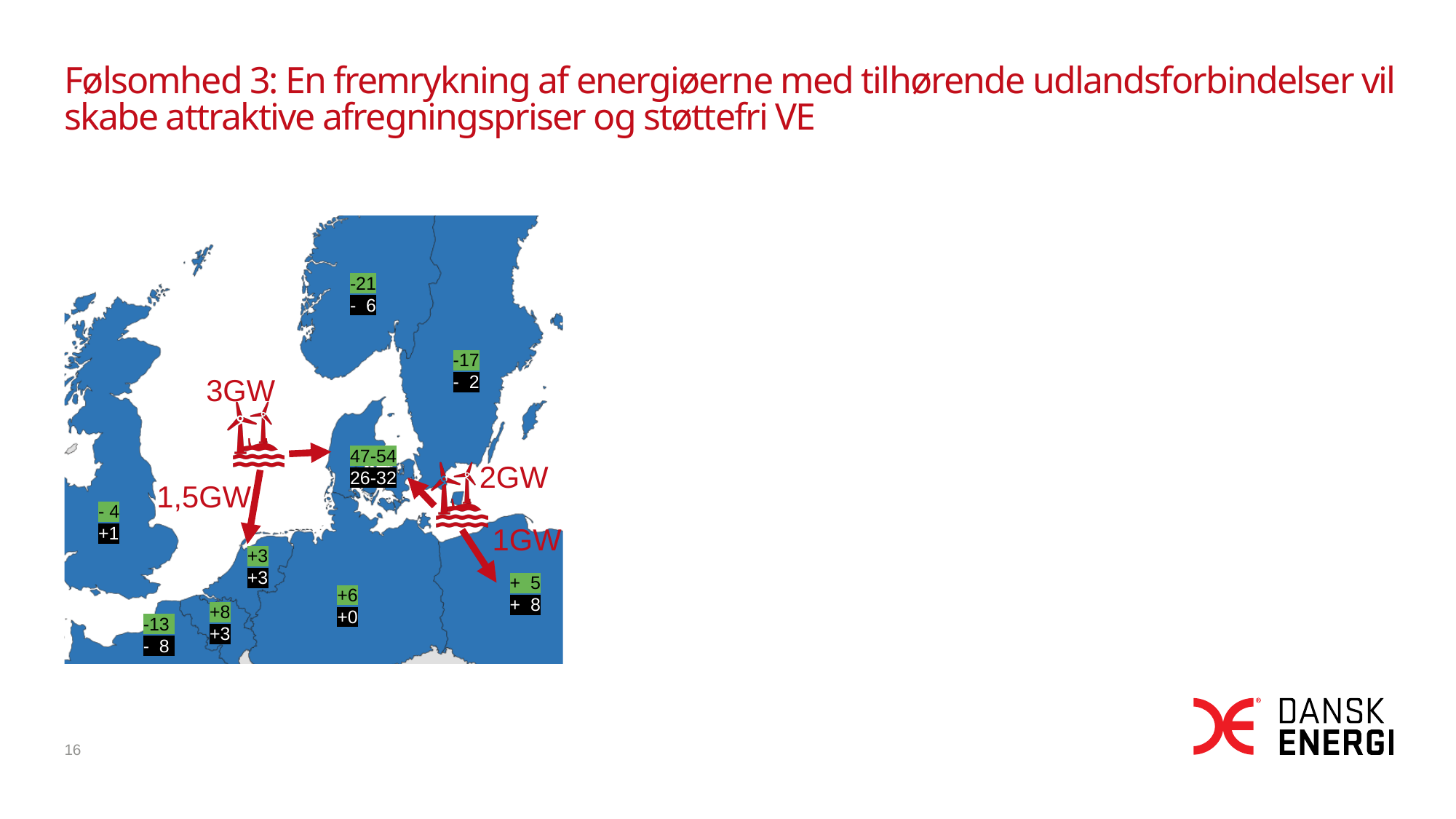
Which is larger, the 3GW label or the 1,5GW label on the map? 3GW What capacity is labelled next to the wind turbine icon in the Baltic Sea, east of Denmark? 2GW How many GW capacity labels are shown on the map? 4 What capacity is labelled on the arrow pointing south from the North Sea wind turbine icon? 1,5GW What is the smallest wind capacity labelled on the map? 1GW What is the green value shown on the label in Denmark, where the 3GW arrow points? 47-54 What is the largest wind capacity labelled on the map? 3GW What is the black value shown on the label in Denmark, where the 3GW arrow points? 26-32